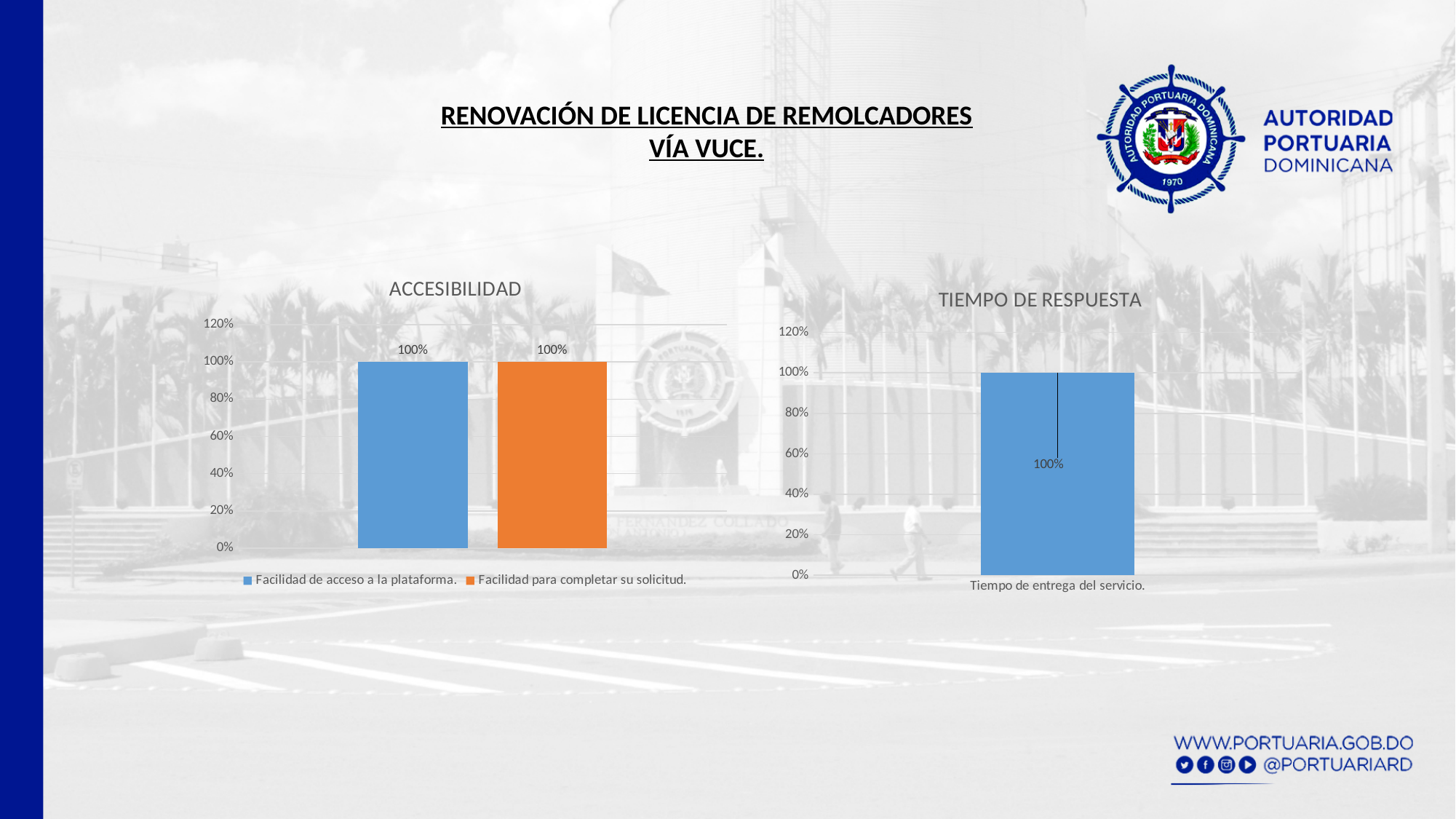
In the ACCESIBILIDAD chart, is the value for Facilidad para completar su solicitud greater or less than 60%? greater In the TIEMPO DE RESPUESTA chart, what is the value for Tiempo de entrega del servicio? 100% How many bars are plotted in the TIEMPO DE RESPUESTA chart? 1 In the ACCESIBILIDAD chart, what is the value for Facilidad para completar su solicitud? 100% In the ACCESIBILIDAD chart, what is the value for Facilidad de acceso a la plataforma? 100% In the TIEMPO DE RESPUESTA chart, is the value for Tiempo de entrega del servicio greater or less than 80%? greater In the ACCESIBILIDAD chart, what is the difference between Facilidad de acceso a la plataforma and Facilidad para completar su solicitud? 0% What is the title of the chart on the right side of the slide? TIEMPO DE RESPUESTA What kind of chart is the ACCESIBILIDAD chart? Bar chart What kind of chart is the TIEMPO DE RESPUESTA chart? Bar chart How many series does the legend of the ACCESIBILIDAD chart list? 2 In the ACCESIBILIDAD chart, which colour is used for the Facilidad para completar su solicitud series? Orange